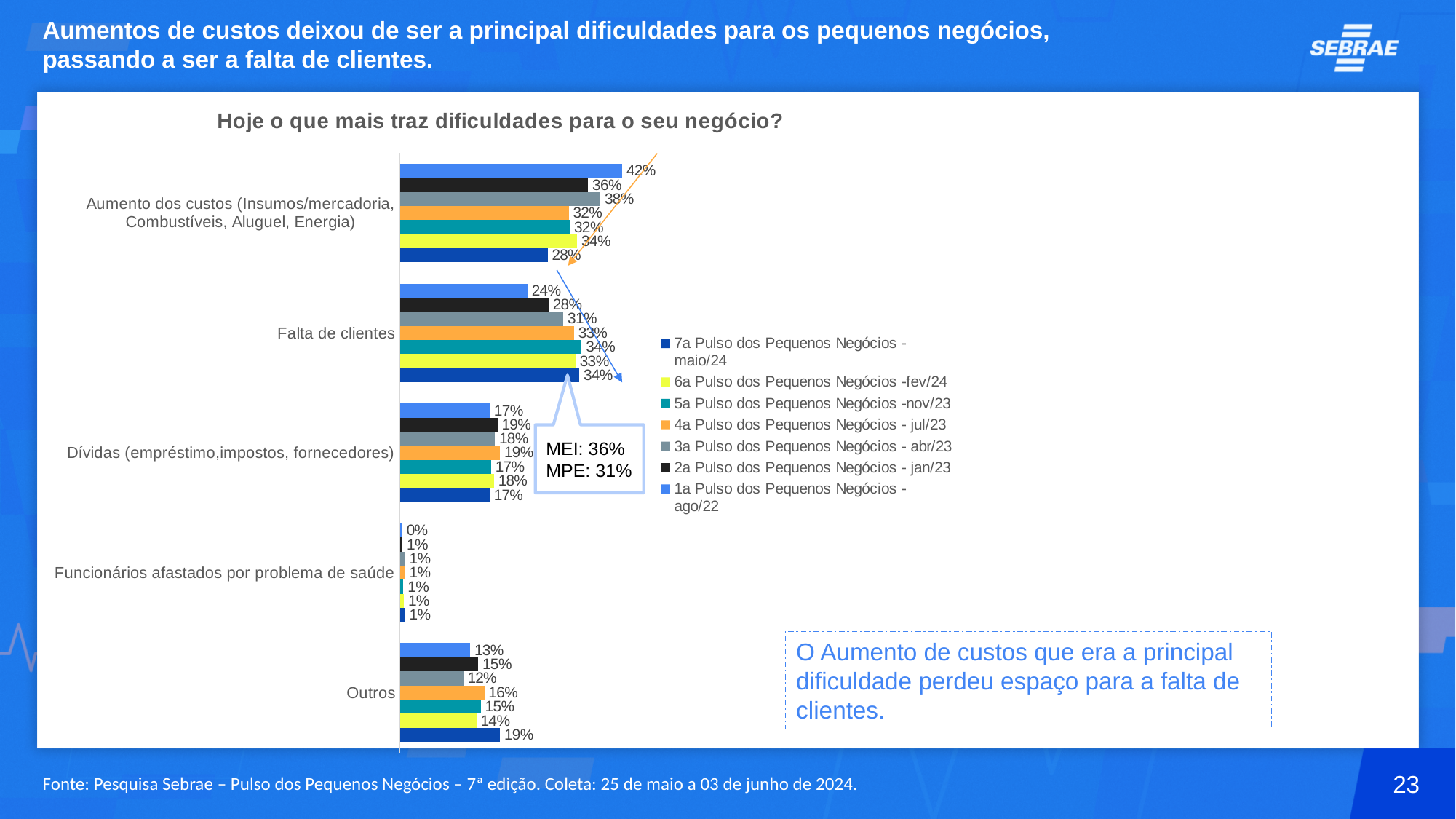
What is the value for 'Outros' in the '7a Pulso dos Pequenos Negócios - maio/24' series? 19% What is the difference between the 'Aumento dos custos' values for the 1a (ago/22) and 7a (maio/24) series? 14 percentage points How many categories are shown on the chart? 5 What is the value for 'Falta de clientes' in the '7a Pulso dos Pequenos Negócios - maio/24' series? 34% What is the value for 'Aumento dos custos' in the '7a Pulso dos Pequenos Negócios - maio/24' series? 28% What kind of chart is shown on the slide? Bar chart From the 1a (ago/22) series to the 7a (maio/24) series, does the value for 'Falta de clientes' rise or fall? Rise In the '7a Pulso dos Pequenos Negócios - maio/24' series, which is larger: 'Aumento dos custos' or 'Falta de clientes'? Falta de clientes In the '7a Pulso dos Pequenos Negócios - maio/24' series, which category has the highest value? Falta de clientes Which category has the lowest values across all series? Funcionários afastados por problema de saúde What is the value for 'Aumento dos custos' in the '1a Pulso dos Pequenos Negócios - ago/22' series? 42% How many series does the legend list? 7